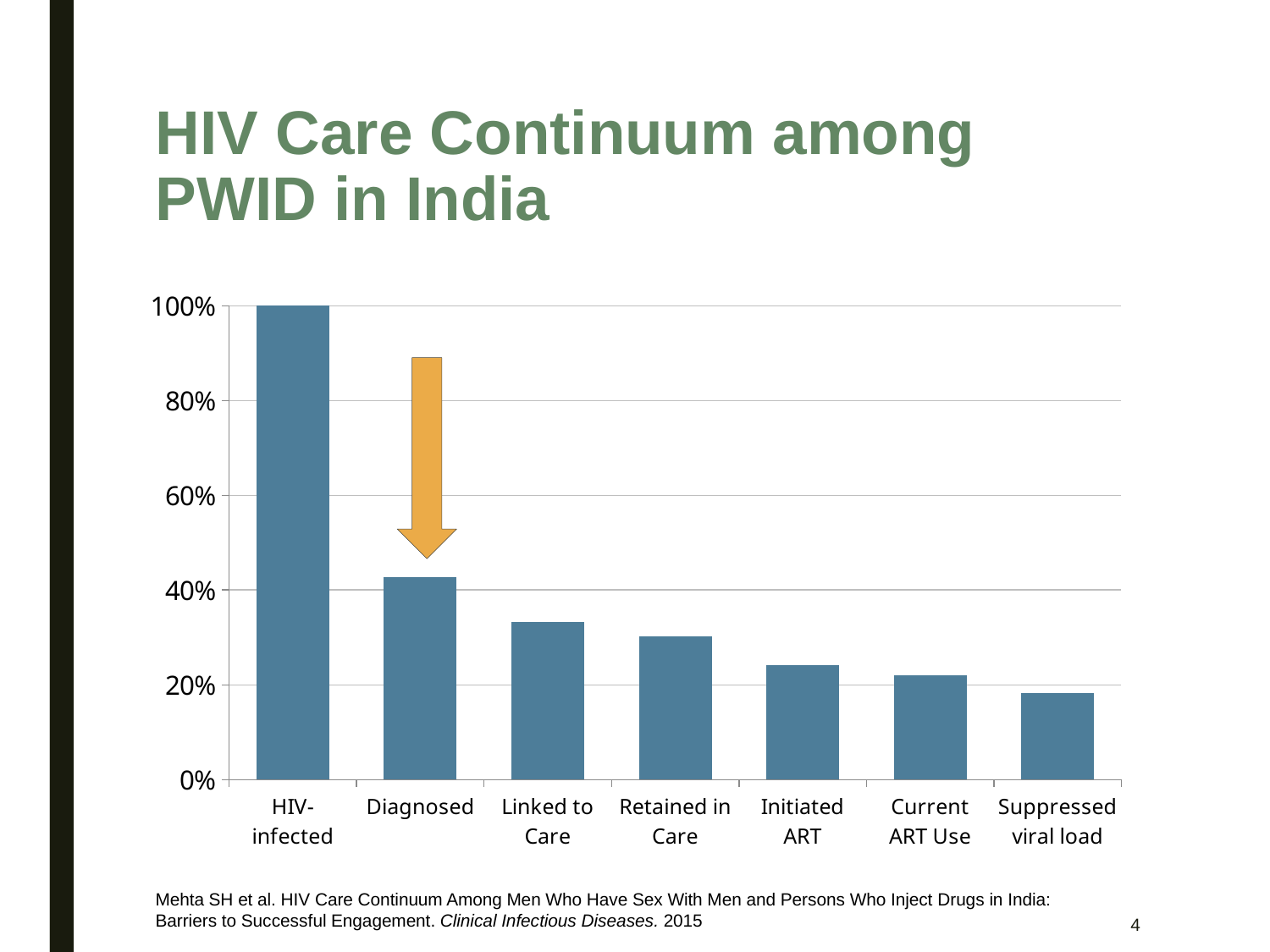
Is the value for Diagnosed greater or less than 40%? greater Is the value for Suppressed viral load greater or less than 20%? less Which category has the lowest value? Suppressed viral load Do the values rise or fall moving from left to right along the x axis? fall Which category has the highest value? HIV-infected Is the value for Retained in Care greater or less than 20%? greater How many categories are shown along the x axis of the chart? 7 What kind of chart is shown on the slide? bar chart What is the value for HIV-infected? 100% Which is larger, the value for Diagnosed or the value for Initiated ART? Diagnosed Which bar does the orange arrow on the chart point to? Diagnosed